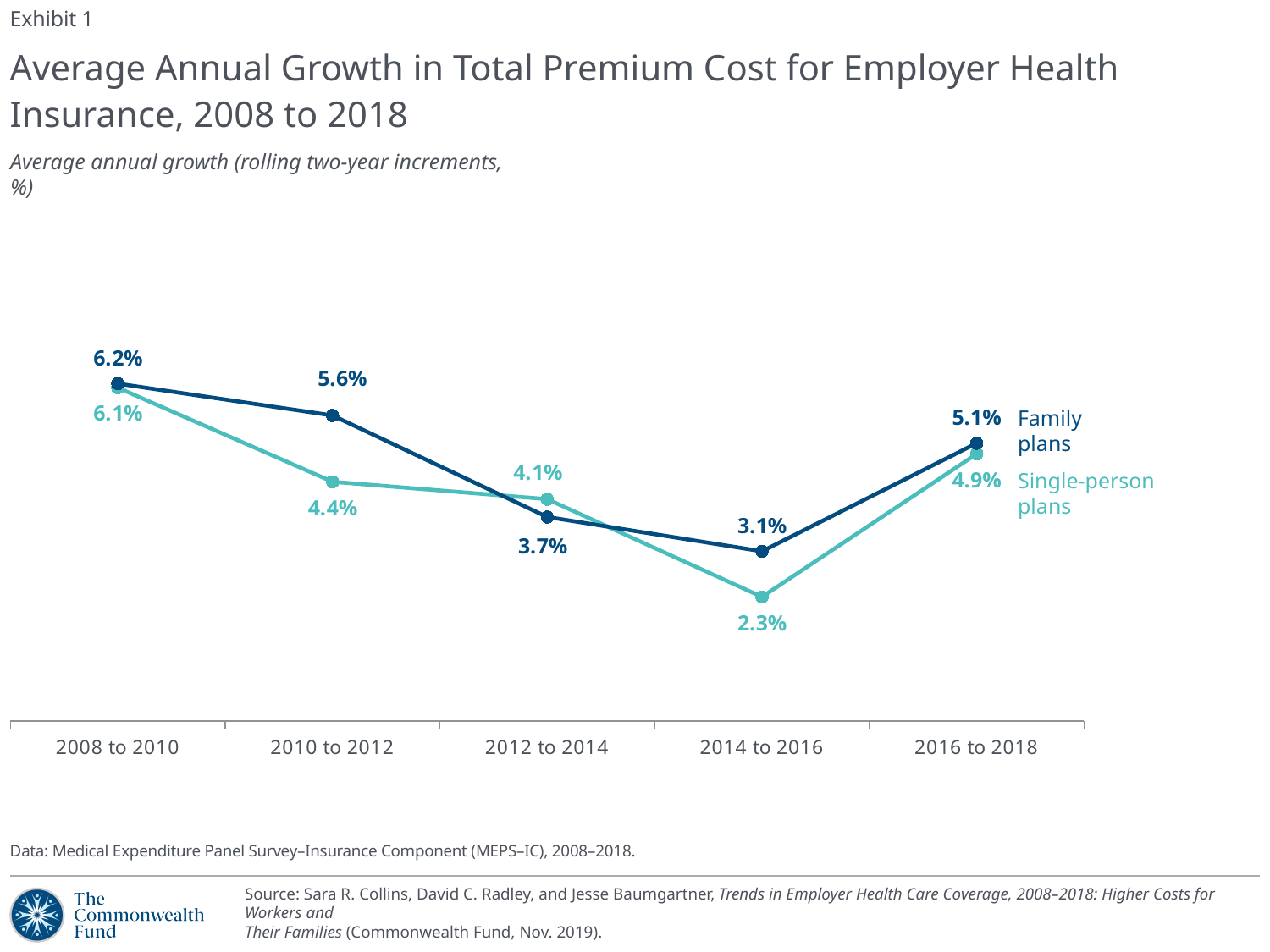
How many series does the chart show? 2 In which period is the average annual growth for family plans lowest? 2014 to 2016 What kind of chart is this? Line chart What is the average annual growth for family plans in 2016 to 2018? 5.1% What is the average annual growth for family plans in 2008 to 2010? 6.2% What is the average annual growth for single-person plans in 2014 to 2016? 2.3% Which is larger in 2012 to 2014, the value for family plans or for single-person plans? Single-person plans In which period is the average annual growth for single-person plans highest? 2008 to 2010 How many time periods are shown on the x axis? 5 Does the average annual growth for family plans rise or fall from 2008 to 2010 through 2014 to 2016? Fall What is the difference between family plans and single-person plans in 2010 to 2012? 1.2 percentage points What is the average annual growth for single-person plans in 2010 to 2012? 4.4%